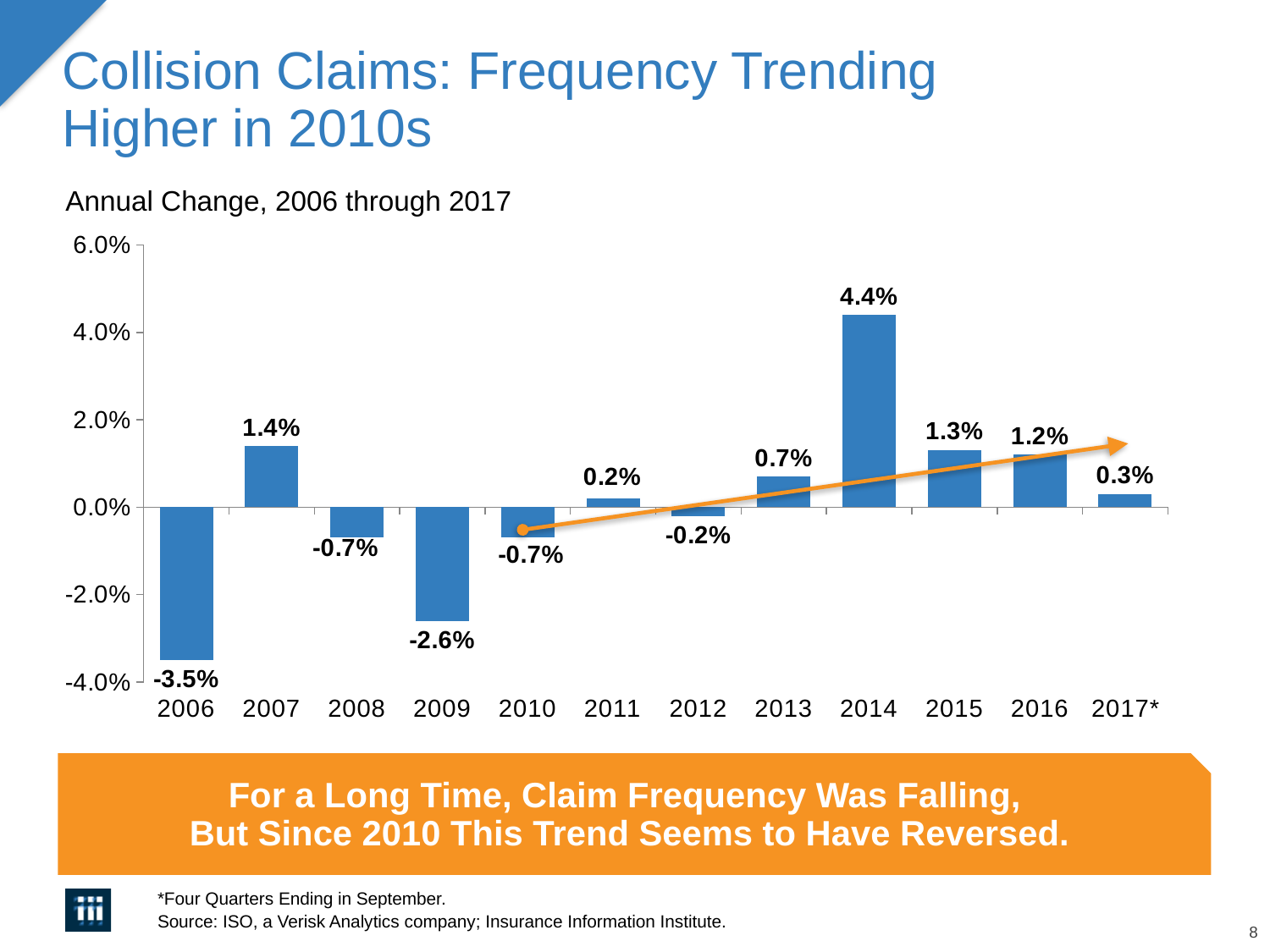
Which year has the highest annual change? 2014 What is the annual change in collision claim frequency for 2014? 4.4% What is the difference between the annual change in 2014 and in 2015? 3.1% How many years are shown on the x axis? 12 What kind of chart is shown on the slide? Bar chart What is the subtitle printed above the chart? Annual Change, 2006 through 2017 Is the value for 2009 greater or less than -2.0%? less What is the annual change shown for 2017*? 0.3% Which year has the lowest annual change? 2006 Which year has the larger annual change, 2007 or 2013? 2007 Do the annual change values generally rise or fall from 2010 to 2014? Rise What is the annual change shown for 2006? -3.5%